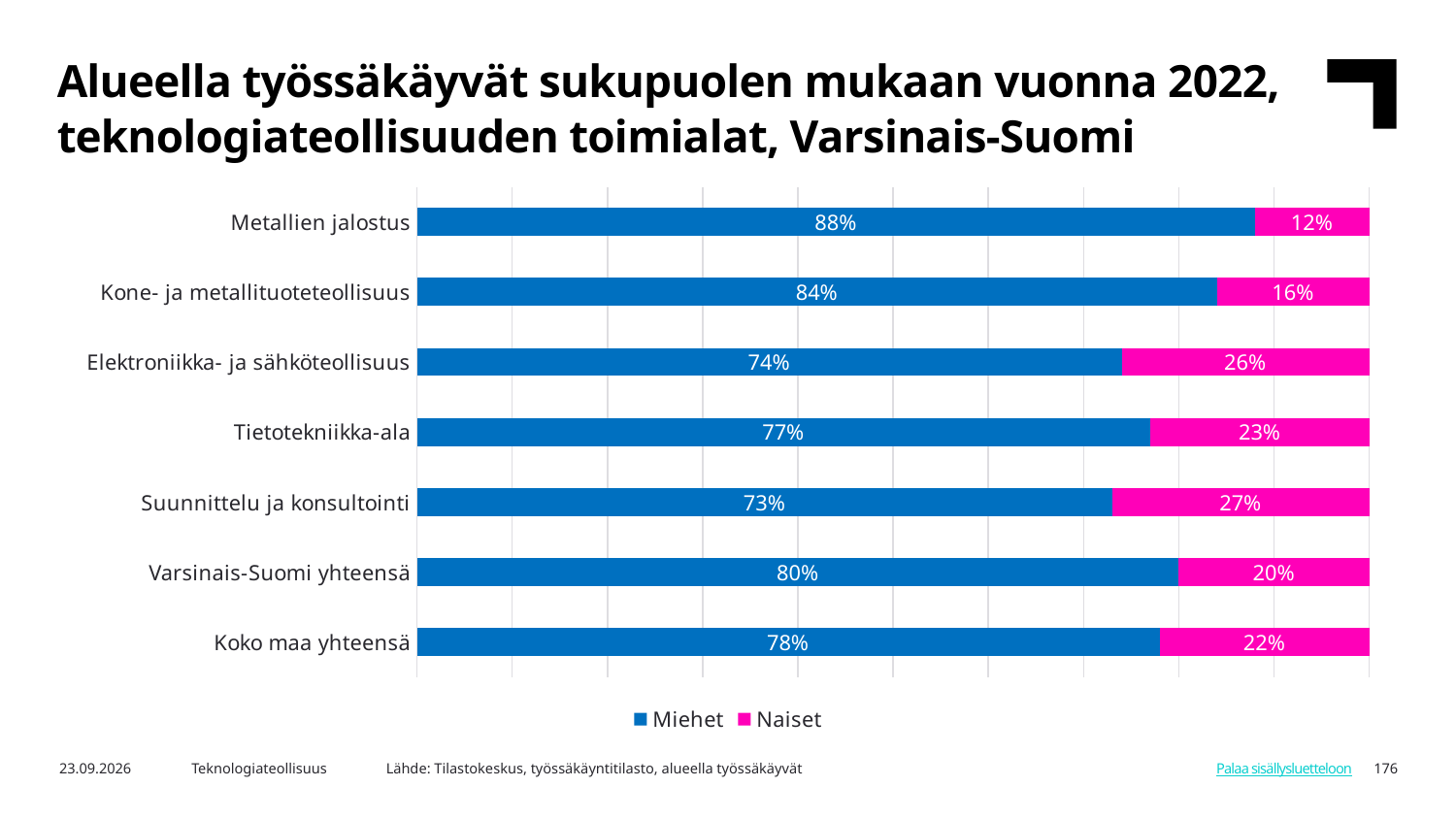
What is the Naiset share for Suunnittelu ja konsultointi? 27% Which category has the lowest Naiset share? Metallien jalostus How many categories are shown on the chart? 7 What kind of chart is shown on the slide? Stacked bar chart Which is larger, the Naiset share for Elektroniikka- ja sähköteollisuus or for Koko maa yhteensä? Elektroniikka- ja sähköteollisuus What is the difference between the Miehet share for Kone- ja metallituoteteollisuus and for Tietotekniikka-ala? 7 percentage points Which category has the highest Miehet share? Metallien jalostus What is the total of the stacked bar for Tietotekniikka-ala? 100% What is the Naiset share for Varsinais-Suomi yhteensä? 20% How many series does the legend list? 2 What is the Miehet share for Metallien jalostus? 88% Which category has the highest Naiset share? Suunnittelu ja konsultointi